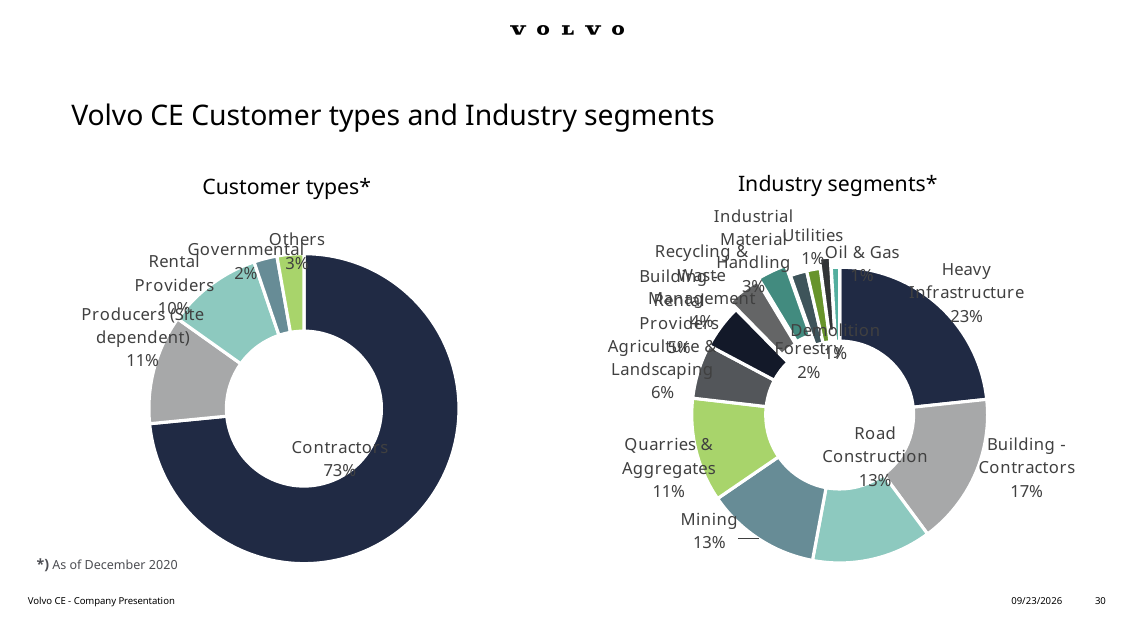
In the Industry segments chart, which segment has the largest share? Heavy Infrastructure In the Customer types chart, which customer type has the largest share? Contractors What kind of chart is the Customer types chart? Donut (pie) chart In the Industry segments chart, what share does Heavy Infrastructure have? 23% In the Industry segments chart, what share does Quarries & Aggregates have? 11% In the Customer types chart, which customer type has the smallest share? Governmental In the Customer types chart, what is the difference between the shares of Producers (Site dependent) and Rental Providers? 1% In the Customer types chart, what share do Rental Providers have? 10% In the Customer types chart, what share do Contractors have? 73% How many customer types are shown in the Customer types chart? 5 In the Industry segments chart, what is the difference between the shares of Heavy Infrastructure and Mining? 10% In the Industry segments chart, which is larger: Building - Contractors or Road Construction? Building - Contractors